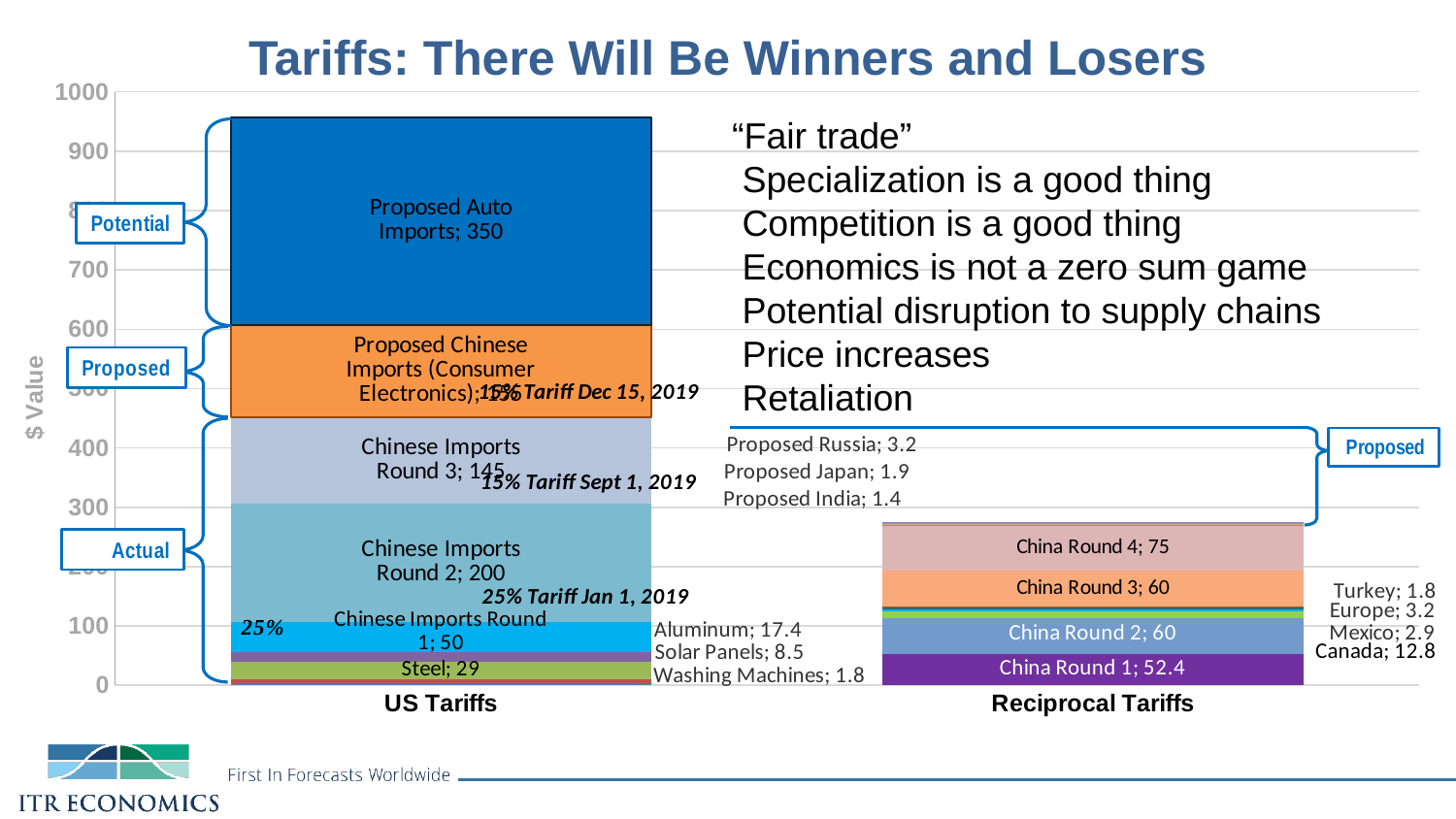
What is the value of the Chinese Imports Round 2 segment in the US Tariffs bar? 200 How many categories are shown on the x axis of the chart? 2 What kind of chart is shown on the slide? Stacked bar chart Which segment of the US Tariffs bar has the largest value? Proposed Auto Imports What is the value of the Steel segment in the US Tariffs bar? 29 What is the value of the Aluminum segment in the US Tariffs bar? 17.4 Which is larger, the China Round 4 segment or the China Round 1 segment in the Reciprocal Tariffs bar? China Round 4 What is the value of the Proposed Auto Imports segment in the US Tariffs bar? 350 What is the difference between the Chinese Imports Round 2 and Chinese Imports Round 1 segments? 150 Is the total height of the Reciprocal Tariffs bar greater or less than 300? less What is the value of the Canada segment in the Reciprocal Tariffs bar? 12.8 What is the value of the China Round 4 segment in the Reciprocal Tariffs bar? 75